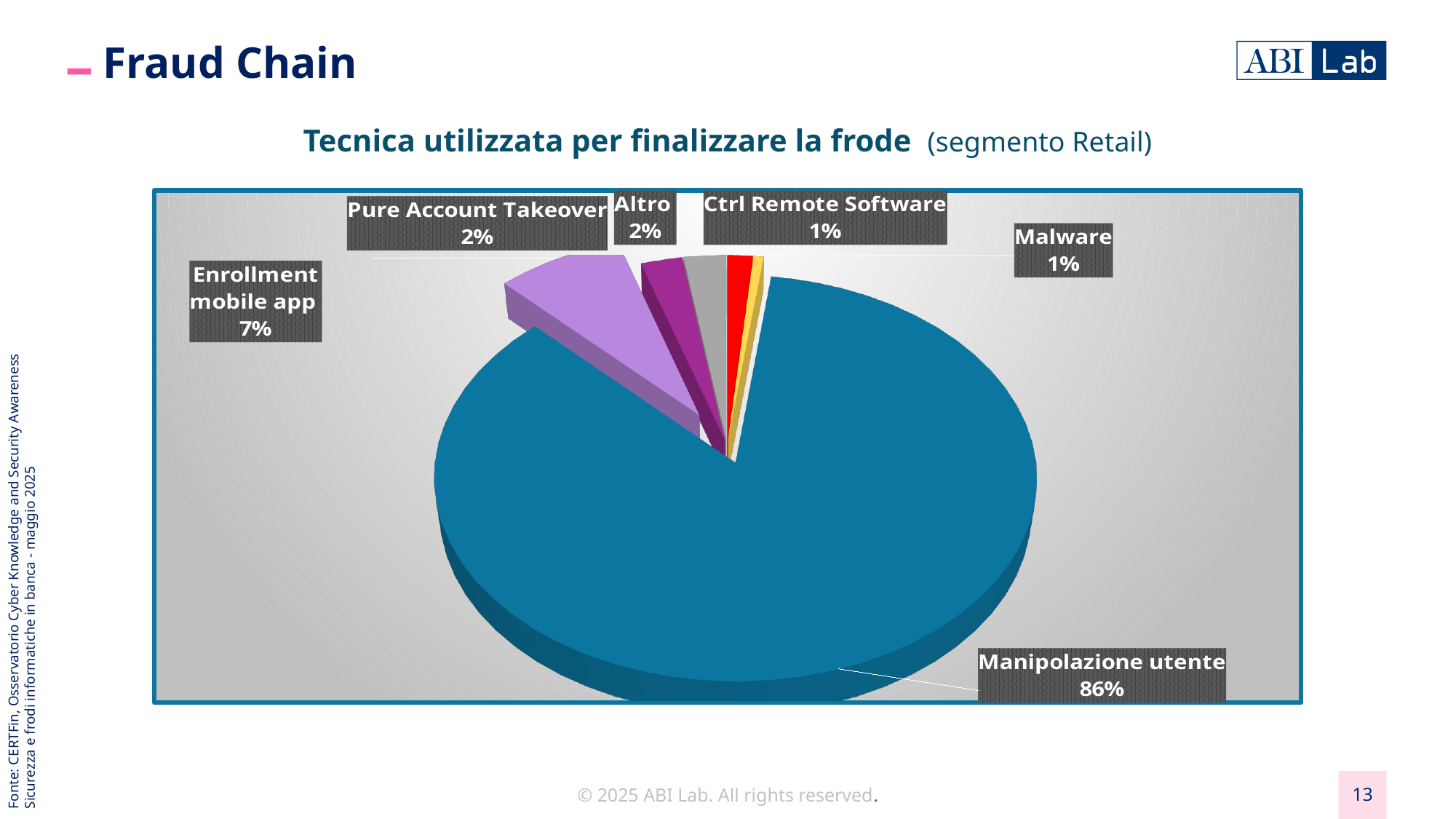
Which is larger, Enrollment mobile app or Pure Account Takeover? Enrollment mobile app What is the title of the chart? Tecnica utilizzata per finalizzare la frode (segmento Retail) What is the difference between Manipolazione utente and Enrollment mobile app? 79% Which category has the largest slice of the pie? Manipolazione utente What colour is the Manipolazione utente slice? Blue What is the value for Pure Account Takeover? 2% What is the value for Ctrl Remote Software? 1% What kind of chart is shown on the slide? Pie chart What is the value for Enrollment mobile app? 7% What share of the pie does Manipolazione utente hold? 86% How many categories are shown in the pie chart? 6 What is the value for Altro? 2%